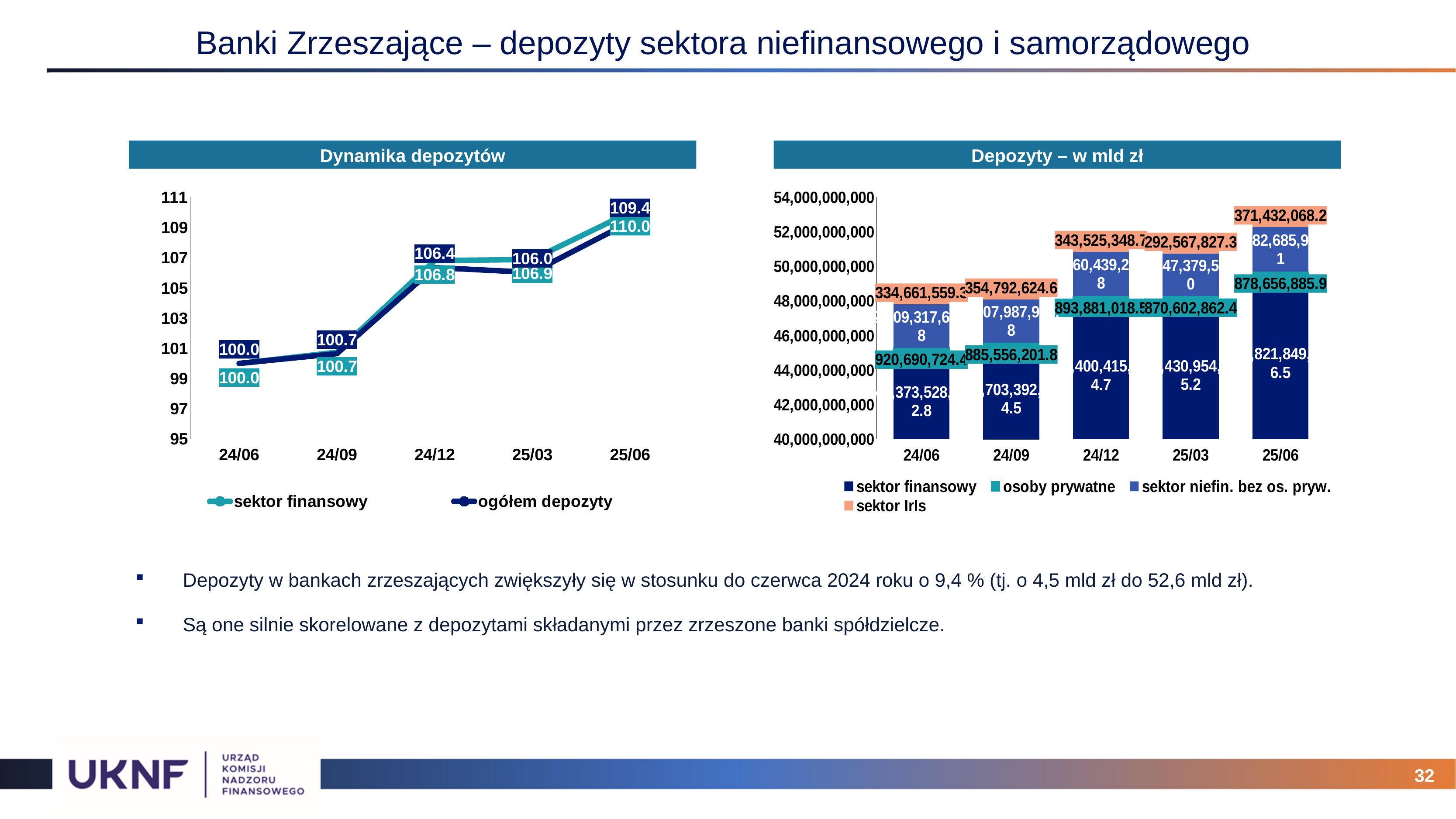
In the 'Dynamika depozytów' chart, at which period is 'ogółem depozyty' lowest? 24/06 In the 'Dynamika depozytów' chart, which series has the higher value at 25/06, 'sektor finansowy' or 'ogółem depozyty'? sektor finansowy What kind of chart is 'Dynamika depozytów'? line chart In the 'Dynamika depozytów' chart, how many periods are shown on the x axis? 5 In the 'Dynamika depozytów' chart, at which period does 'sektor finansowy' reach its highest value? 25/06 In the 'Dynamika depozytów' chart, what is the difference between the 'sektor finansowy' value at 25/06 and at 24/06? 10.0 What kind of chart is 'Depozyty – w mld zł'? stacked bar chart How many series does the legend of the 'Depozyty – w mld zł' chart list? 4 In the 'Dynamika depozytów' chart, what is the value of 'ogółem depozyty' at 25/06? 109.4 In the 'Dynamika depozytów' chart, does 'ogółem depozyty' rise or fall between 24/12 and 25/03? fall In the 'Dynamika depozytów' chart, what is the value of 'sektor finansowy' at 25/03? 106.9 In the 'Dynamika depozytów' chart, what is the value of 'ogółem depozyty' at 24/12? 106.4